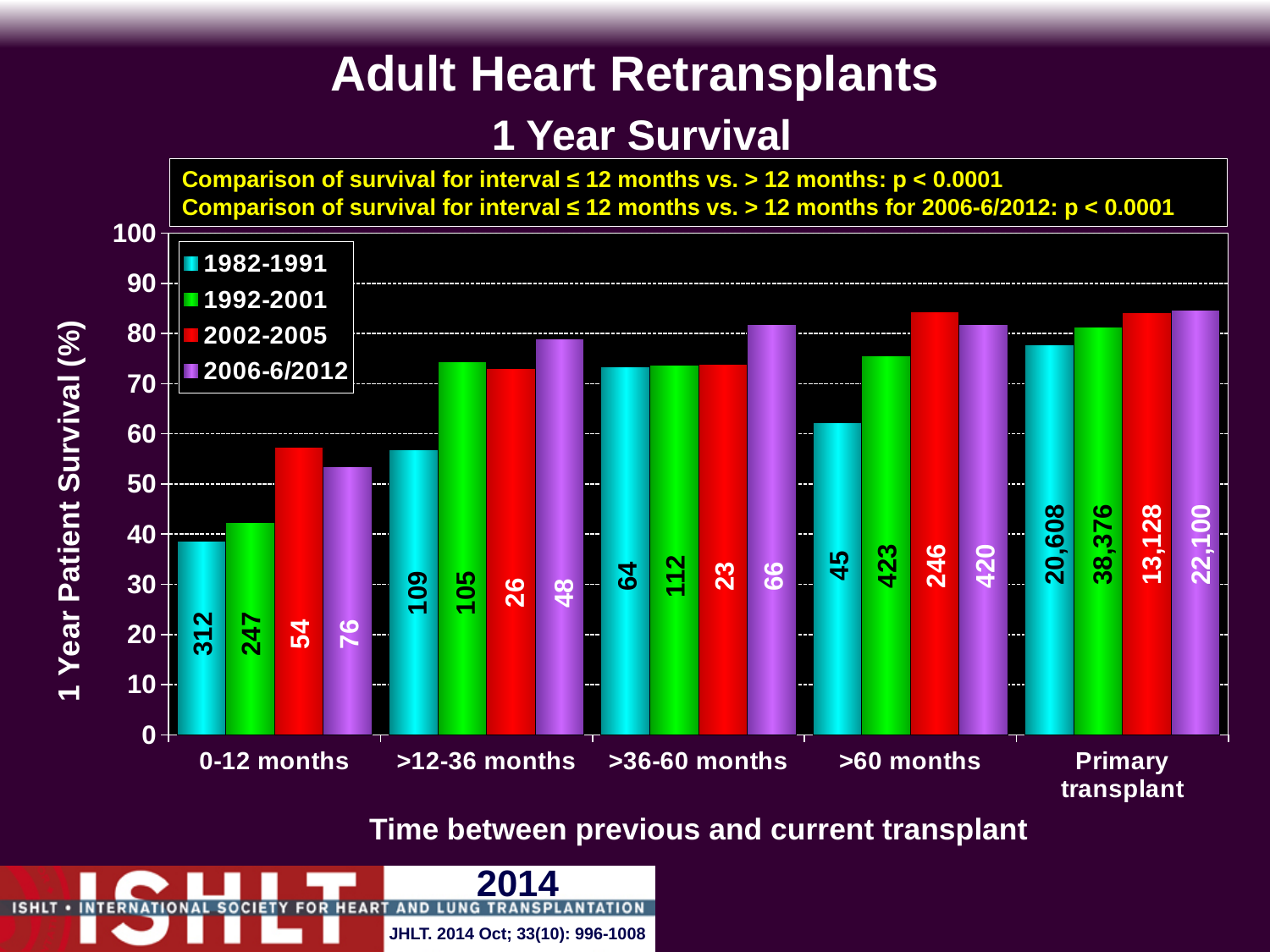
What kind of chart is shown on the slide? bar chart For the 1982-1991 series, which category has the lowest 1 year survival? 0-12 months Do the 2002-2005 values generally rise or fall from 0-12 months to Primary transplant? rise Is the 1 year survival for 1982-1991 in the >60 months category greater or less than 70? less Is the 1 year survival for 2002-2005 in the 0-12 months category greater or less than 50? greater Which series has the lowest 1 year survival in the 0-12 months category? 1982-1991 What is the label of the y axis? 1 Year Patient Survival (%) Which series has the highest 1 year survival in the 0-12 months category? 2002-2005 What is the label of the x axis? Time between previous and current transplant How many categories are shown on the x axis of the chart? 5 In the >60 months category, which is larger: the 1982-1991 value or the 1992-2001 value? 1992-2001 How many series does the legend list? 4